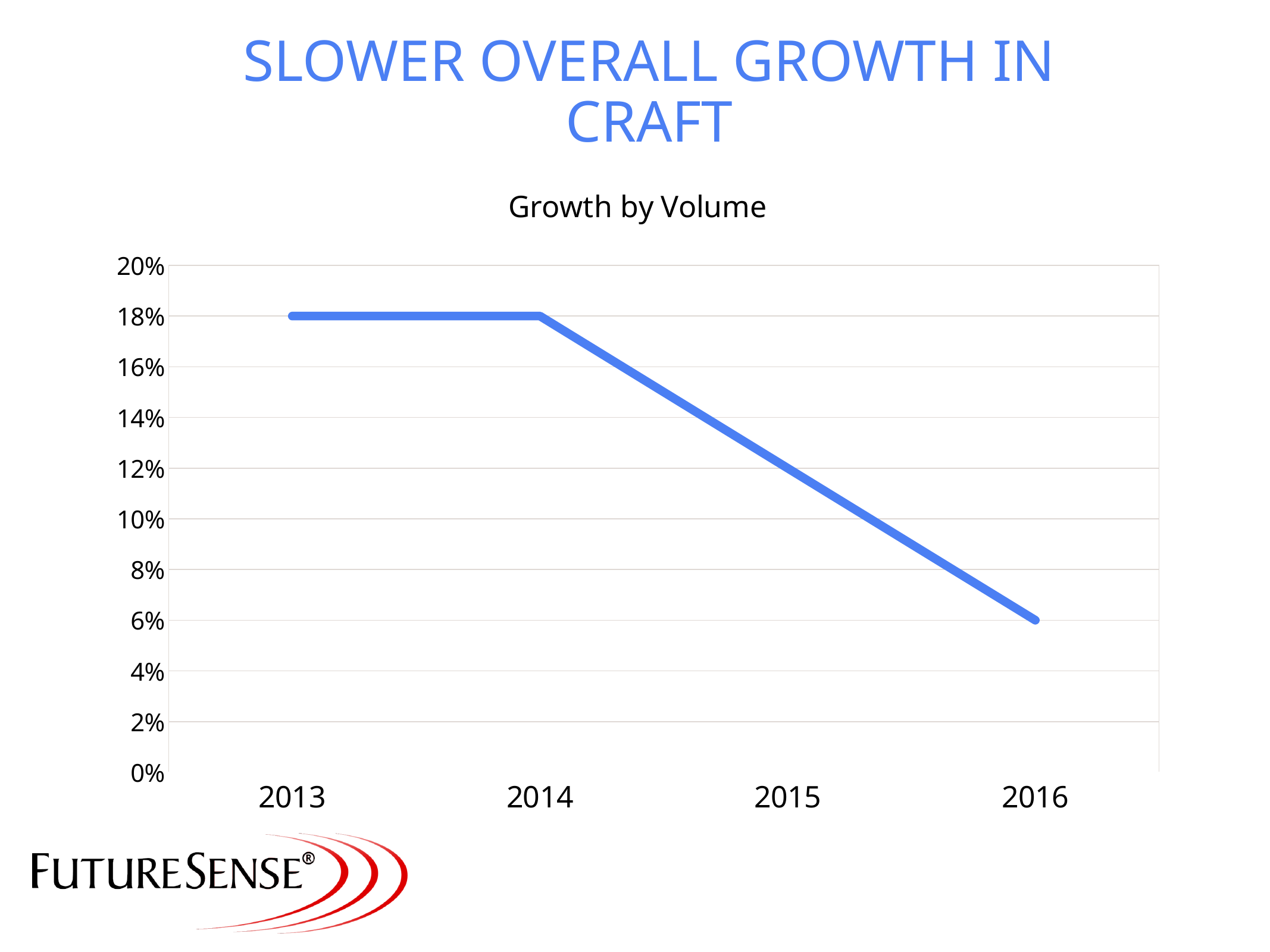
Which year has the lowest growth by volume? 2016 What is the title of the chart? Growth by Volume What is the difference in growth by volume between 2014 and 2016? 12% What is the growth by volume for 2016? 6% What is the growth by volume for 2014? 18% What kind of chart is shown on the slide? Line chart Which year has higher growth by volume, 2015 or 2016? 2015 Does growth by volume rise or fall from 2014 to 2016? Fall How many years are plotted on the x axis? 4 Is the growth by volume for 2015 greater or less than 10%? greater What is the growth by volume for 2013? 18% What is the growth by volume for 2015? 12%